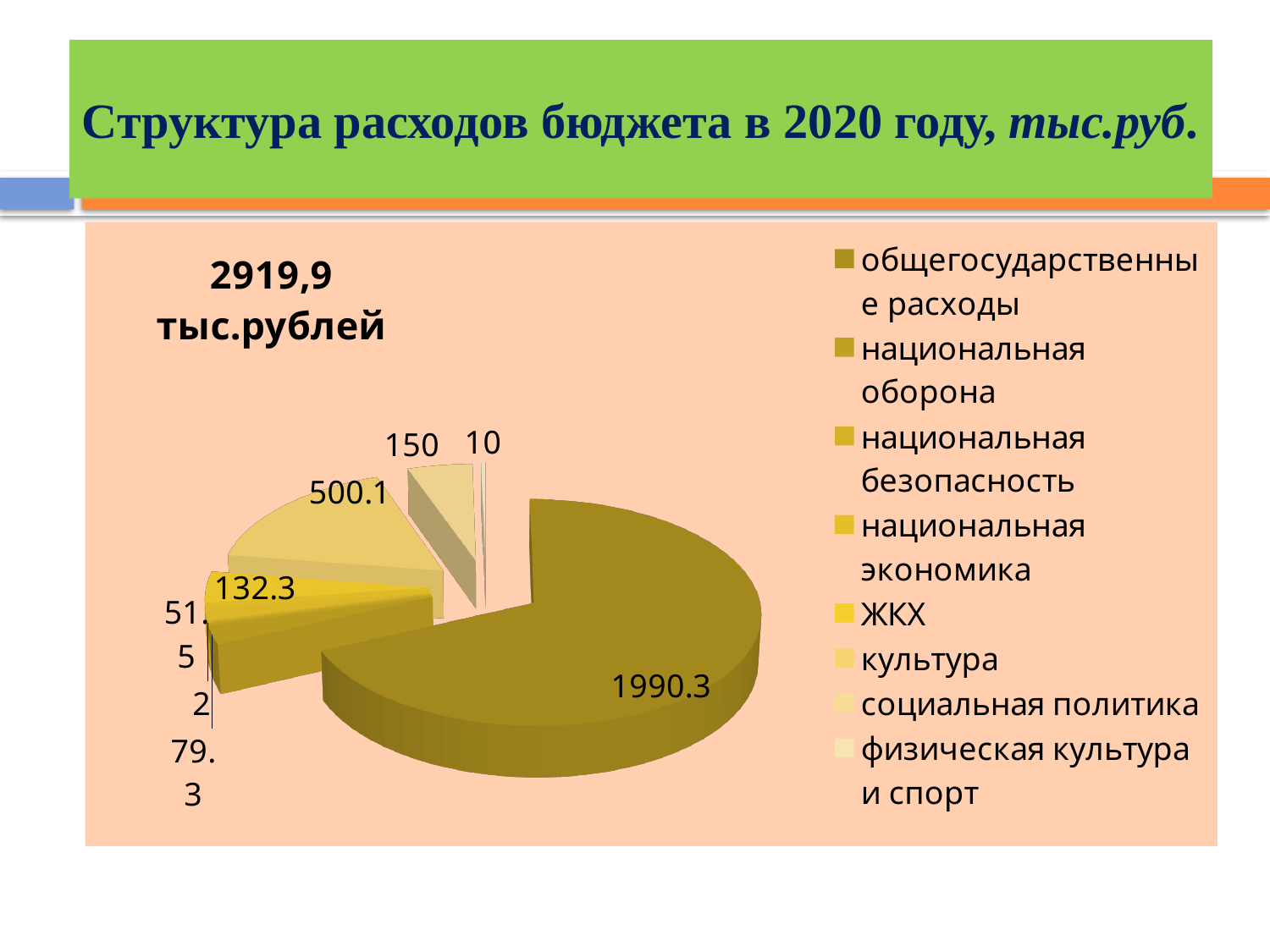
What value is shown for the ЖКХ slice? 132.3 What is the value shown for the largest slice of the pie chart? 1990.3 What value is shown for the культура slice? 500.1 What kind of chart is shown on the slide? pie chart Which category has the largest slice of the pie chart? общегосударственные расходы What total amount is written in the top-left of the chart area? 2919,9 тыс.рублей What is the difference between the largest slice (1990.3) and the культура slice (500.1)? 1490.2 What is the title of the slide? Структура расходов бюджета в 2020 году, тыс.руб. Which slice is larger, культура or ЖКХ? культура How many categories does the legend of the pie chart list? 8 How many data labels are shown on the pie chart? 8 What is the smallest value labelled on the pie chart? 2